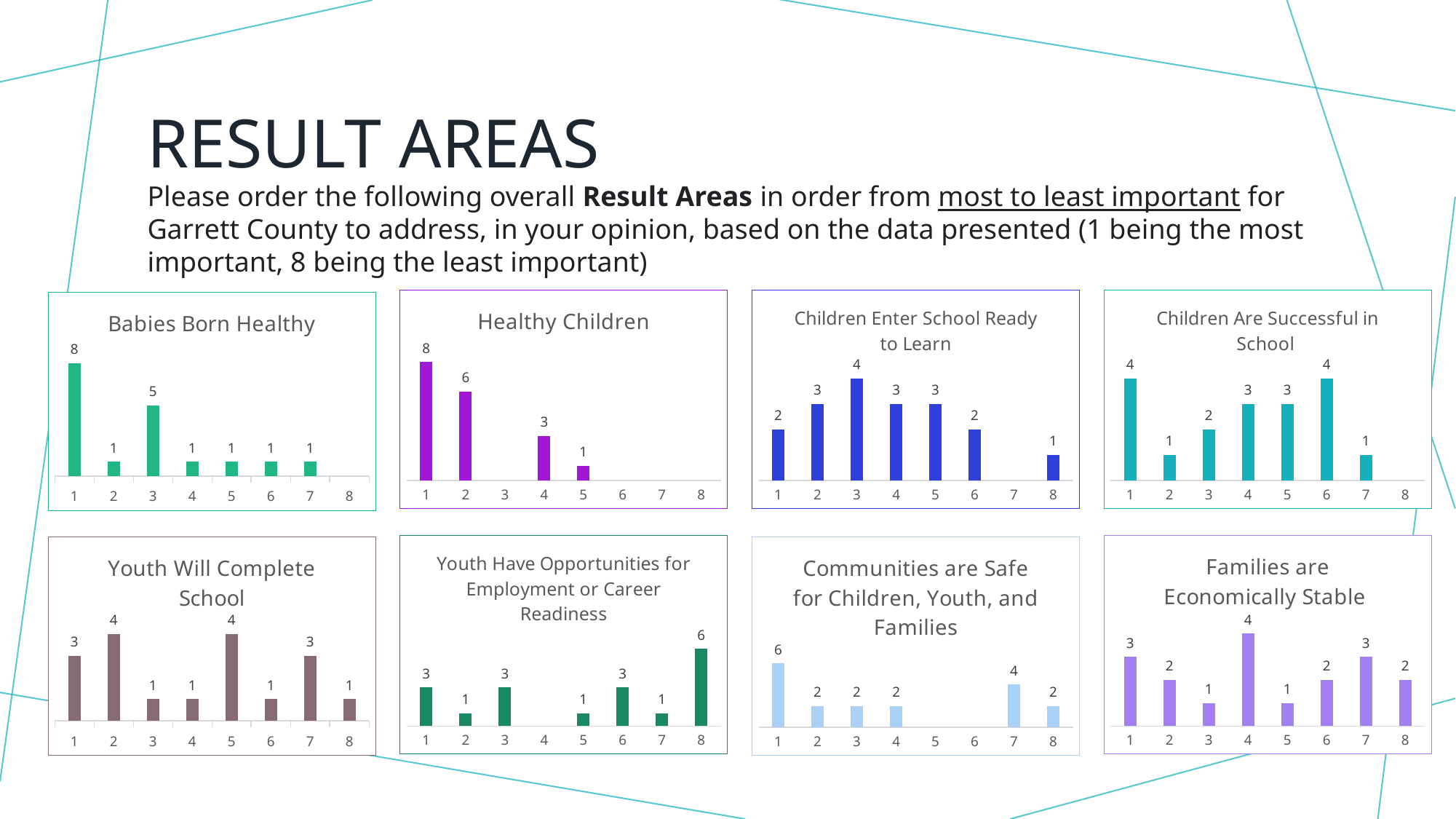
How many charts are shown on the slide? 8 In the "Children Are Successful in School" chart, what is the difference between the values for rank 1 and rank 2? 3 In the "Children Enter School Ready to Learn" chart, what is the value for rank 3? 4 In the "Youth Will Complete School" chart, which is larger, the value for rank 2 or the value for rank 3? rank 2 In the "Communities are Safe for Children, Youth, and Families" chart, what is the value for rank 1? 6 In the "Communities are Safe for Children, Youth, and Families" chart, what is the value for rank 7? 4 In the "Healthy Children" chart, what is the difference between the values for rank 1 and rank 2? 2 In the "Families are Economically Stable" chart, which rank has the highest value? 4 In the "Babies Born Healthy" chart, what is the value for rank 1? 8 What type of chart is the "Babies Born Healthy" chart? bar chart In the "Youth Have Opportunities for Employment or Career Readiness" chart, which rank has the highest value? 8 In the "Healthy Children" chart, which rank has the highest value? 1